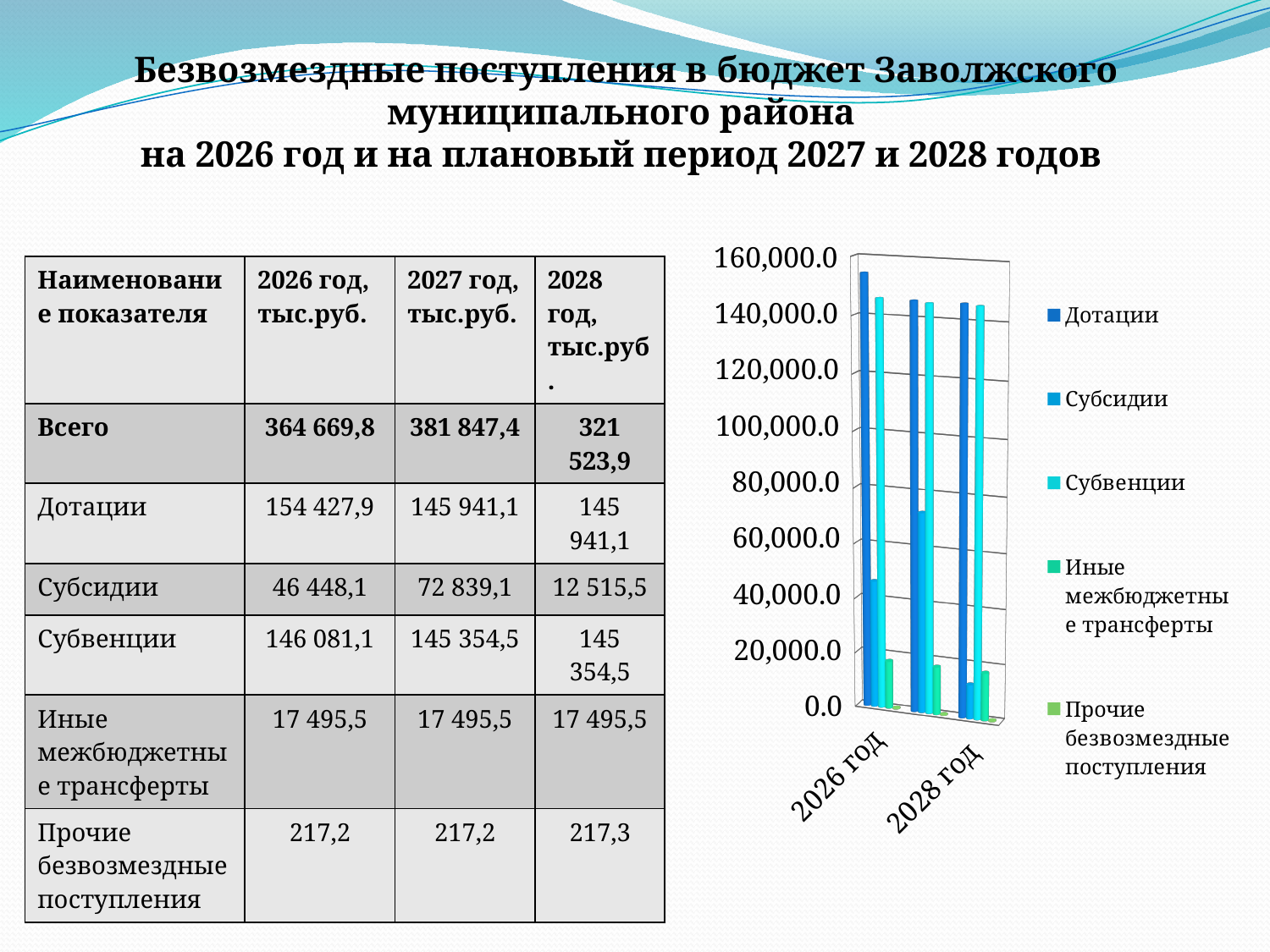
In the chart, does the Субсидии bar rise or fall from the middle year to 2028 год? fall What kind of chart is shown on the right of the slide? bar chart In the chart, which series has the tallest bar for 2026 год? Дотации In the chart, for 2026 год, which is larger: Дотации or Субсидии? Дотации In the chart, is the value for Субсидии in 2026 год greater or less than 40,000.0? greater In the chart, which series has the shortest bars in every year? Прочие безвозмездные поступления In the chart, is the value for Субсидии in 2028 год greater or less than 20,000.0? less How many groups of bars (years) are plotted in the chart? 3 How many series does the chart's legend list? 5 In the chart, is the value for Иные межбюджетные трансферты in 2026 год greater or less than 20,000.0? less